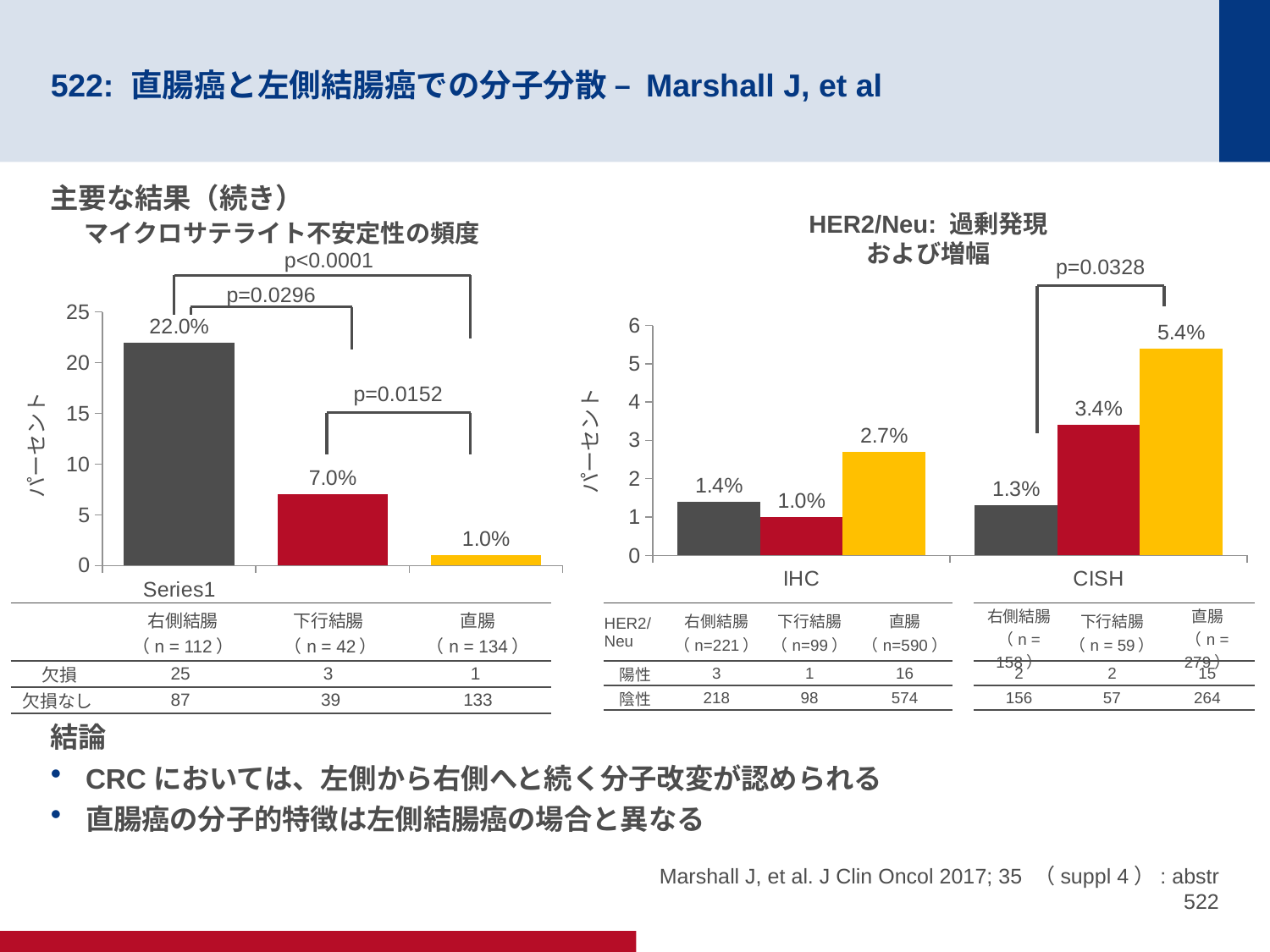
In the マイクロサテライト不安定性の頻度 chart, which category has the highest value? 右側結腸 In the マイクロサテライト不安定性の頻度 chart, do the values rise or fall from left to right? fall In the マイクロサテライト不安定性の頻度 chart, what is the difference between the values for 右側結腸 and 下行結腸? 15.0% In the HER2/Neu chart, what is the difference between the 直腸 values in the CISH and IHC groups? 2.7% In the マイクロサテライト不安定性の頻度 chart, what is the value for 直腸? 1.0% In the HER2/Neu chart, what is the value for 下行結腸 in the IHC group? 1.0% In the HER2/Neu chart, what is the value for 直腸 in the CISH group? 5.4% In the マイクロサテライト不安定性の頻度 chart, what is the value for 右側結腸? 22.0% In the マイクロサテライト不安定性の頻度 chart, how many bars are plotted? 3 What type of chart is the HER2/Neu chart? bar chart In the HER2/Neu chart, which is larger: 右側結腸 in the CISH group or 下行結腸 in the CISH group? 下行結腸 In the HER2/Neu chart, which bar in the IHC group has the highest value? 直腸